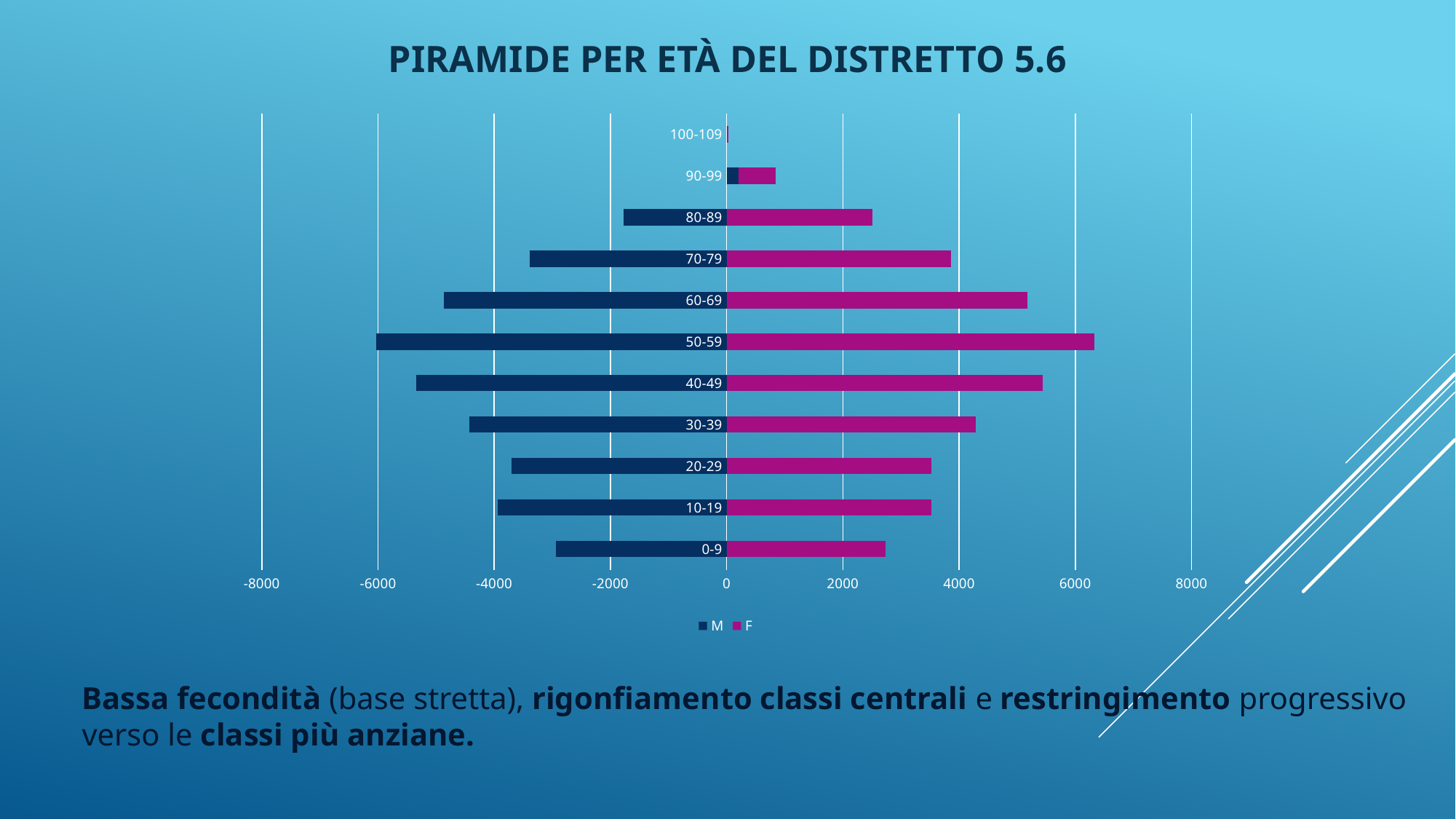
What is the title of the chart? PIRAMIDE PER ETÀ DEL DISTRETTO 5.6 Which age group has the longest M bar? 50-59 What are the two series named in the legend? M and F What kind of chart is shown on the slide? bar chart Which is larger, the F bar for 50-59 or the F bar for 0-9? 50-59 Is the F value for the 60-69 age group greater or less than 4000? greater How many series does the legend list? 2 Which age group has the longest F bar? 50-59 How many age groups are shown on the chart? 11 Is the F value for the 0-9 age group greater or less than 4000? less Is the F value for the 50-59 age group greater or less than 6000? greater Which age group has the shortest F bar? 100-109